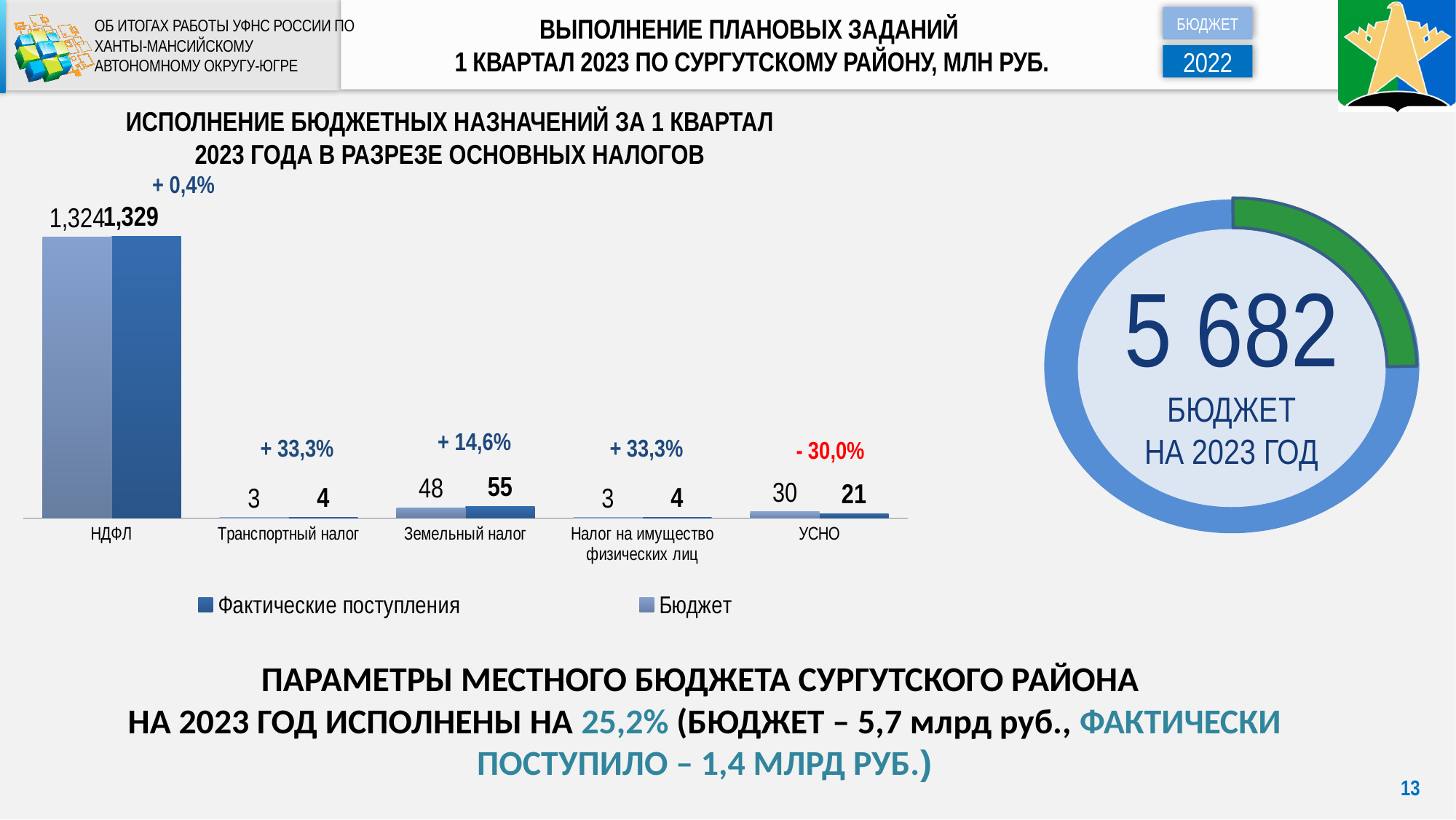
In the bar chart, how many tax categories are shown on the x axis? 5 In the bar chart, for УСНО, which is larger: Бюджет or Фактические поступления? Бюджет In the bar chart, what is the Бюджет value for Транспортный налог? 3 In the bar chart, which category has the highest Фактические поступления value? НДФЛ In the bar chart, what percentage change is shown above the УСНО bars? - 30,0% In the ring chart on the right, what value is shown in the centre? 5 682 In the bar chart, what is the value of Фактические поступления for НДФЛ? 1,329 In the bar chart, what is the value of Фактические поступления for УСНО? 21 What kind of chart is the chart on the left of the slide? Bar chart In the bar chart, what is the Бюджет value for Земельный налог? 48 In the bar chart, what is the difference between Фактические поступления and Бюджет for Земельный налог? 7 In the bar chart, how many series does the legend list? 2